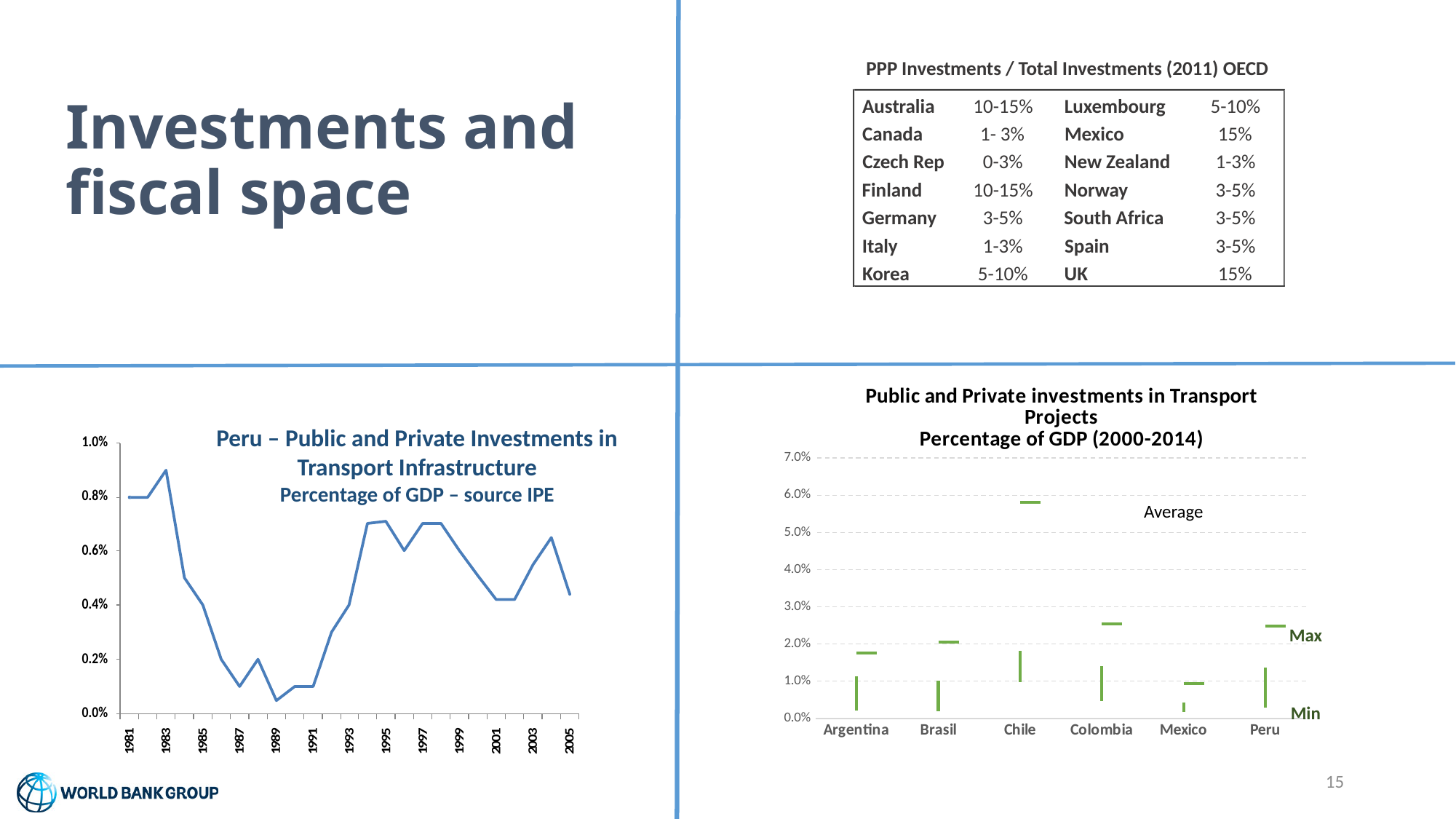
In the Public and Private investments in Transport Projects chart, what three statistics are labelled for each country? Average, Max, Min In the Peru – Public and Private Investments in Transport Infrastructure chart, do the values rise or fall between 1983 and 1989? fall In the Peru – Public and Private Investments in Transport Infrastructure chart, which year has the lowest value? 1989 What source is cited in the subtitle of the Peru – Public and Private Investments in Transport Infrastructure chart? IPE In the Public and Private investments in Transport Projects chart, which country has the highest average value? Chile In the Peru – Public and Private Investments in Transport Infrastructure chart, which year has the highest value? 1983 In the Public and Private investments in Transport Projects chart, how many countries are shown on the x axis? 6 What kind of chart is the Peru – Public and Private Investments in Transport Infrastructure chart? line chart In the Peru – Public and Private Investments in Transport Infrastructure chart, which is larger, the value for 1995 or the value for 2001? 1995 In the Peru – Public and Private Investments in Transport Infrastructure chart, is the value for 1983 greater or less than 0.8%? greater In the Peru – Public and Private Investments in Transport Infrastructure chart, is the value for 1989 greater or less than 0.2%? less